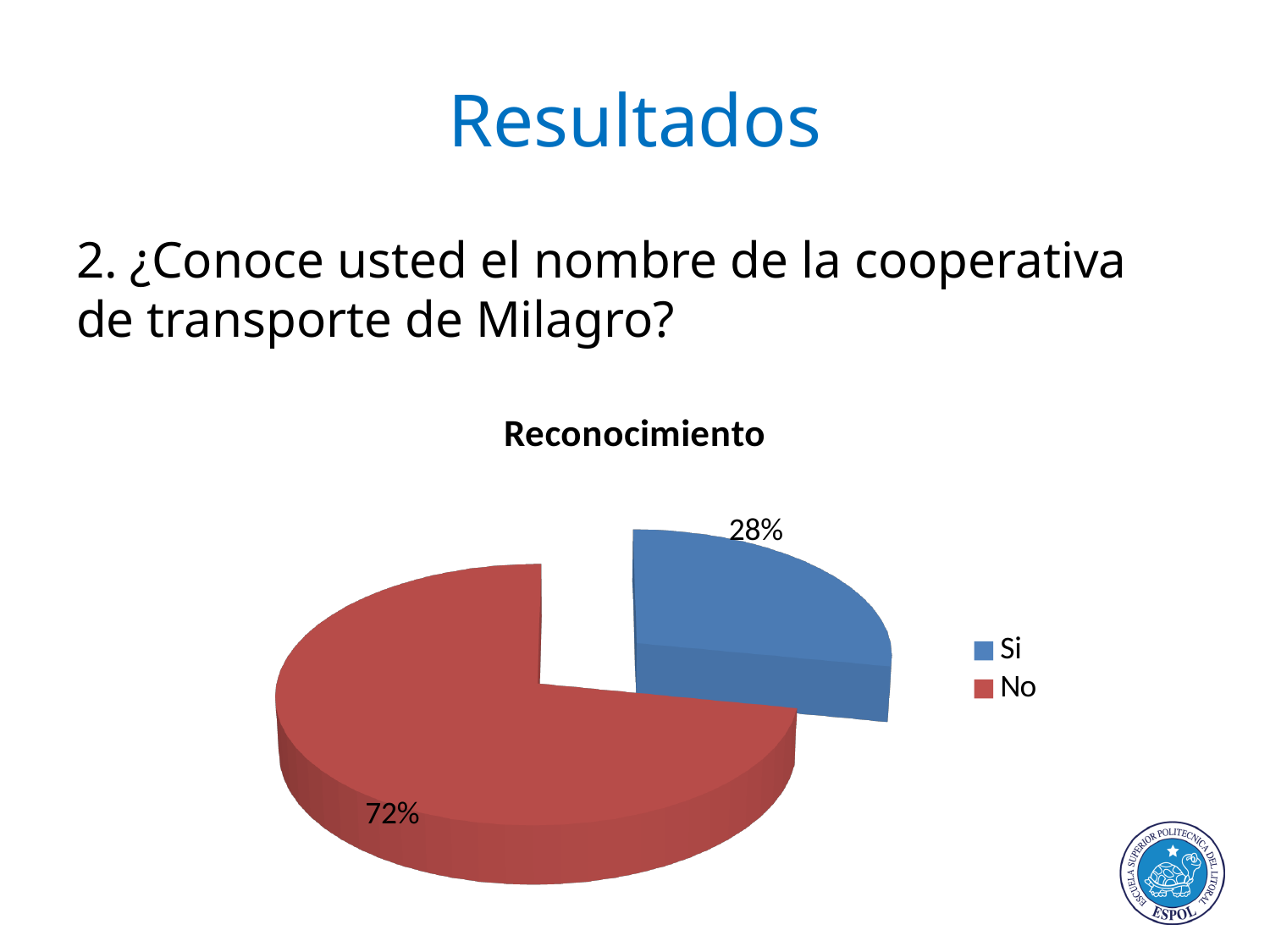
Which slice is larger, "Si" or "No"? No What kind of chart is shown on the slide? Pie chart Which category has the largest share of the pie? No How many entries does the legend list? 2 What colour is the "No" slice? Red What percentage of the pie does the "No" slice represent? 72% Is the share for "Si" greater or less than 50%? less How many slices does the pie chart have? 2 What percentage of the pie does the "Si" slice represent? 28% What is the difference in percentage points between the "No" and "Si" slices? 44 What is the title of the chart? Reconocimiento Which category has the smallest share of the pie? Si